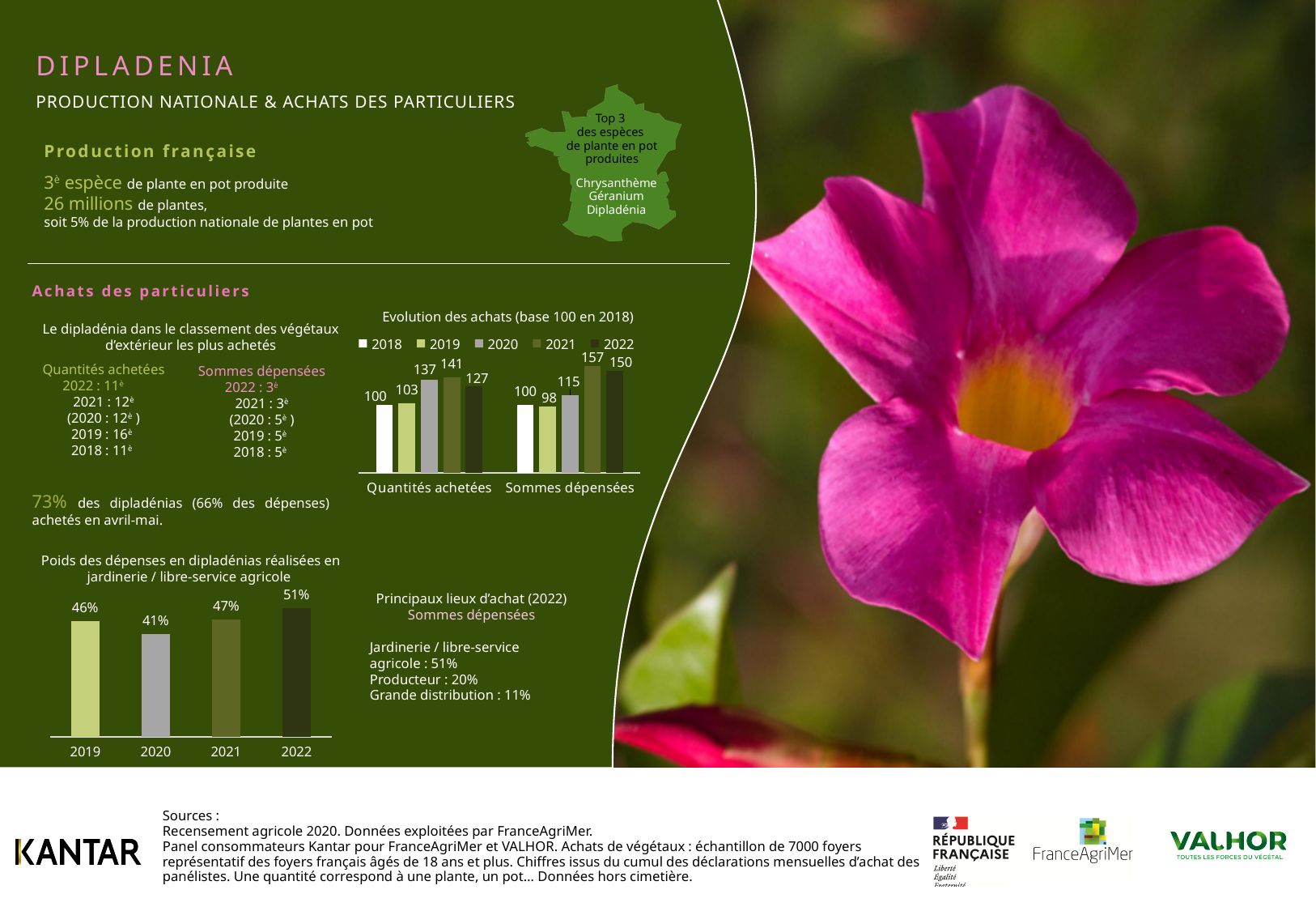
How many years are shown in the 'Poids des dépenses en dipladénias réalisées en jardinerie / libre-service agricole' chart? 4 What kind of chart is 'Evolution des achats (base 100 en 2018)'? Bar chart In the 'Evolution des achats (base 100 en 2018)' chart, what is the difference between the 2021 and 2022 values for Quantités achetées? 14 In the 'Poids des dépenses en dipladénias réalisées en jardinerie / libre-service agricole' chart, what is the value for 2020? 41% In the 'Evolution des achats (base 100 en 2018)' chart, which year has the highest value for Sommes dépensées? 2021 In the 'Poids des dépenses en dipladénias réalisées en jardinerie / libre-service agricole' chart, which year has the highest value? 2022 In the 'Evolution des achats (base 100 en 2018)' chart, what is the 2021 value for Quantités achetées? 141 In the 'Evolution des achats (base 100 en 2018)' chart, what is the 2019 value for Sommes dépensées? 98 In the 'Evolution des achats (base 100 en 2018)' chart, which is larger: the 2020 value for Quantités achetées or the 2020 value for Sommes dépensées? Quantités achetées In the 'Poids des dépenses en dipladénias réalisées en jardinerie / libre-service agricole' chart, what is the difference between the 2022 and 2019 values? 5% How many series does the legend of the 'Evolution des achats (base 100 en 2018)' chart list? 5 In the 'Evolution des achats (base 100 en 2018)' chart, what is the 2022 value for Sommes dépensées? 150